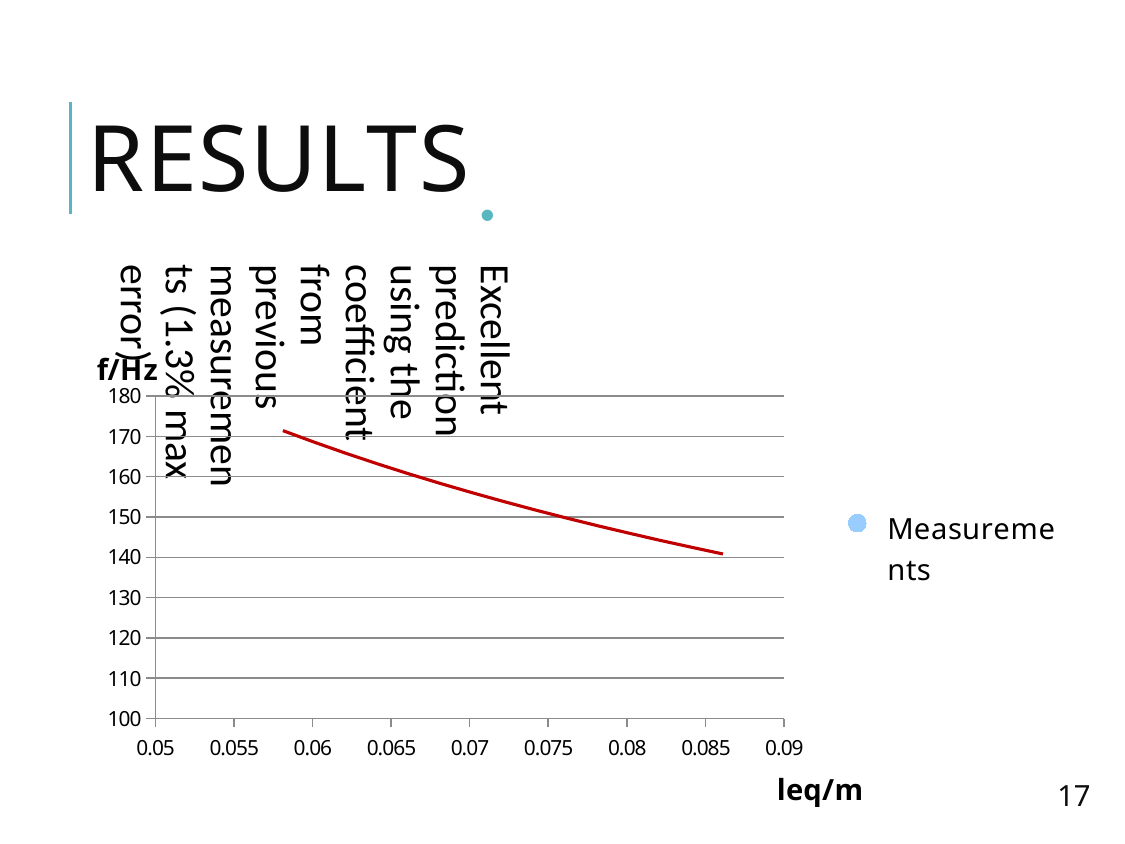
Is the value of the line at leq/m = 0.08 greater or less than 140? greater Which is larger, the value of the line at leq/m = 0.06 or at leq/m = 0.08? 0.06 What kind of chart is shown on the slide? line chart Is the value of the line at leq/m = 0.06 greater or less than 160? greater What is the name of the series listed in the chart legend? Measurements Is the value of the line at leq/m = 0.085 greater or less than 150? less Do the values on the chart rise or fall as leq/m increases along the x axis? fall What is the label on the vertical axis of the chart? f/Hz How many series does the chart legend list? 1